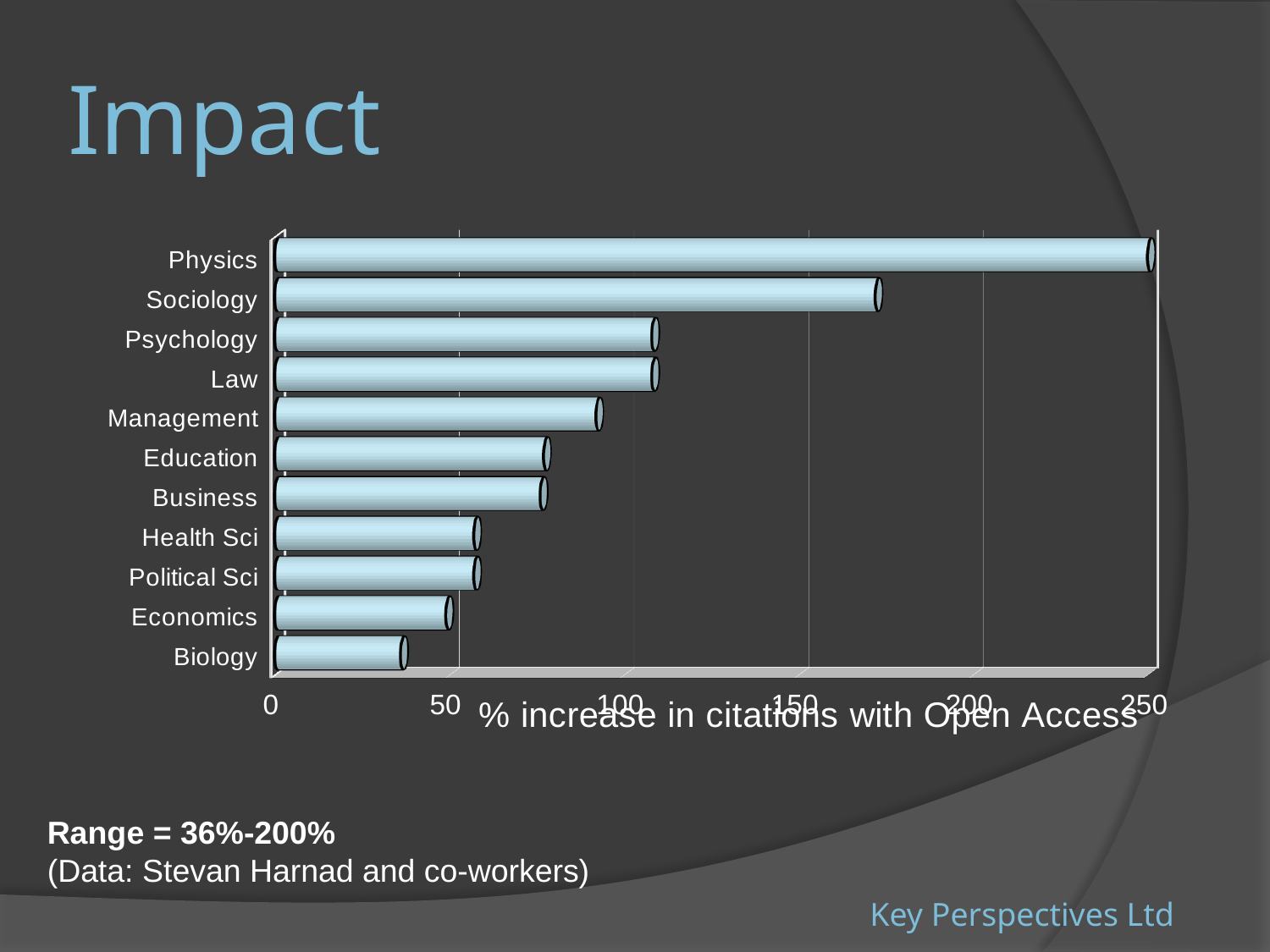
Is the value for Management greater or less than 100? less Which discipline has the lowest % increase in citations with Open Access? Biology Is the value for Sociology greater or less than 150? greater Which discipline has the highest % increase in citations with Open Access? Physics What kind of chart is shown on the slide? bar chart Is the value for Sociology greater or less than 200? less What is the label on the horizontal axis of the chart? % increase in citations with Open Access How many disciplines are plotted in the chart? 11 Which has a larger value, Management or Health Sci? Management Which has a larger value, Sociology or Psychology? Sociology